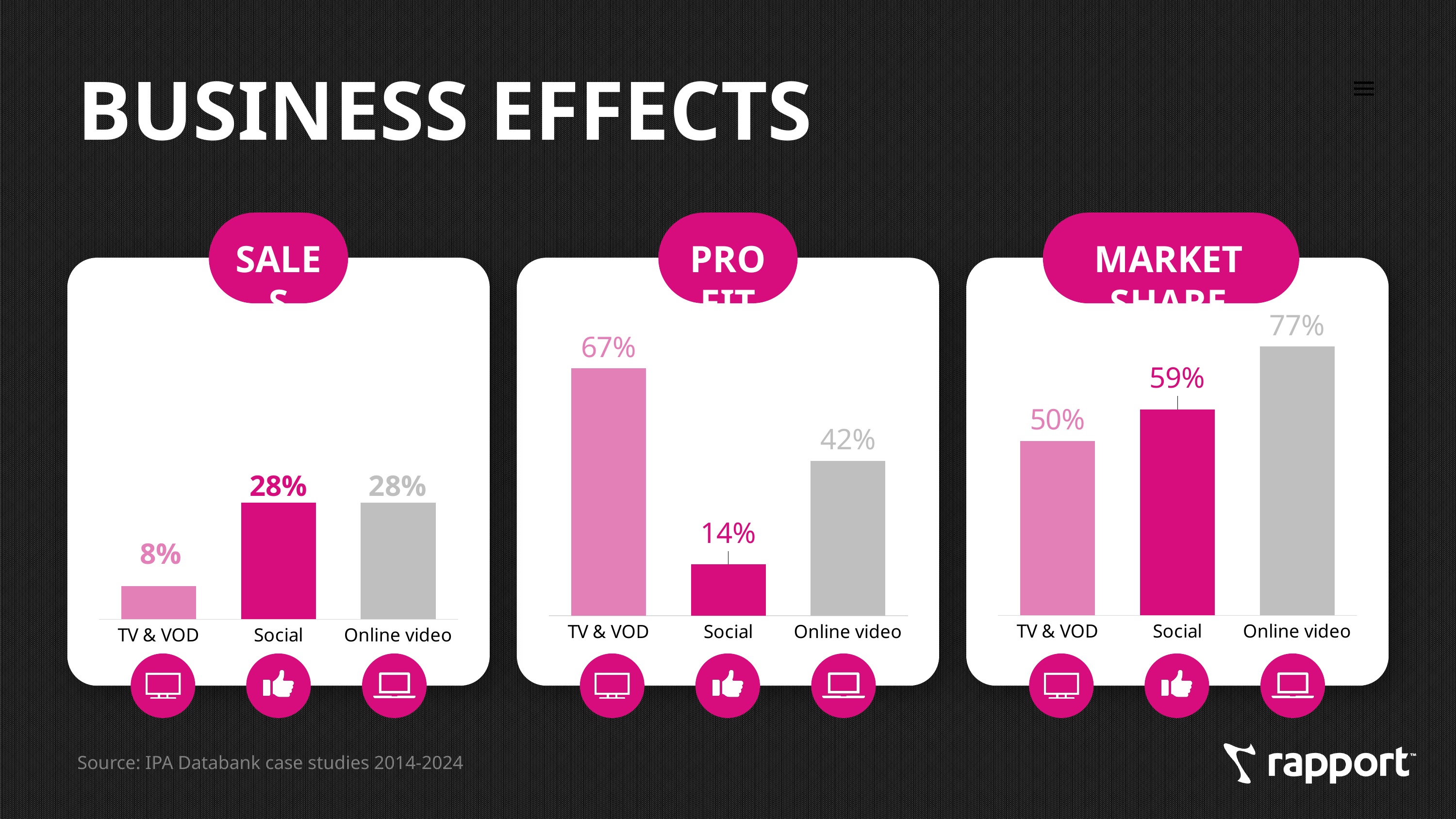
In the right (Market Share) chart, what is the difference between the values for Social and TV & VOD? 9% In the middle (Profit) chart, which category has the highest value? TV & VOD In the middle (Profit) chart, what is the difference between the values for TV & VOD and Social? 53% In the right (Market Share) chart, what is the value for Online video? 77% How many categories are shown in the right (Market Share) chart? 3 In the left (Sales) chart, what is the value for Social? 28% In the right (Market Share) chart, which category has the highest value? Online video In the left (Sales) chart, what is the value for TV & VOD? 8% In the middle (Profit) chart, which is larger, the value for Online video or the value for Social? Online video In the left (Sales) chart, which category has the lowest value? TV & VOD What kind of chart is the middle (Profit) chart? Bar chart In the middle (Profit) chart, what is the value for TV & VOD? 67%